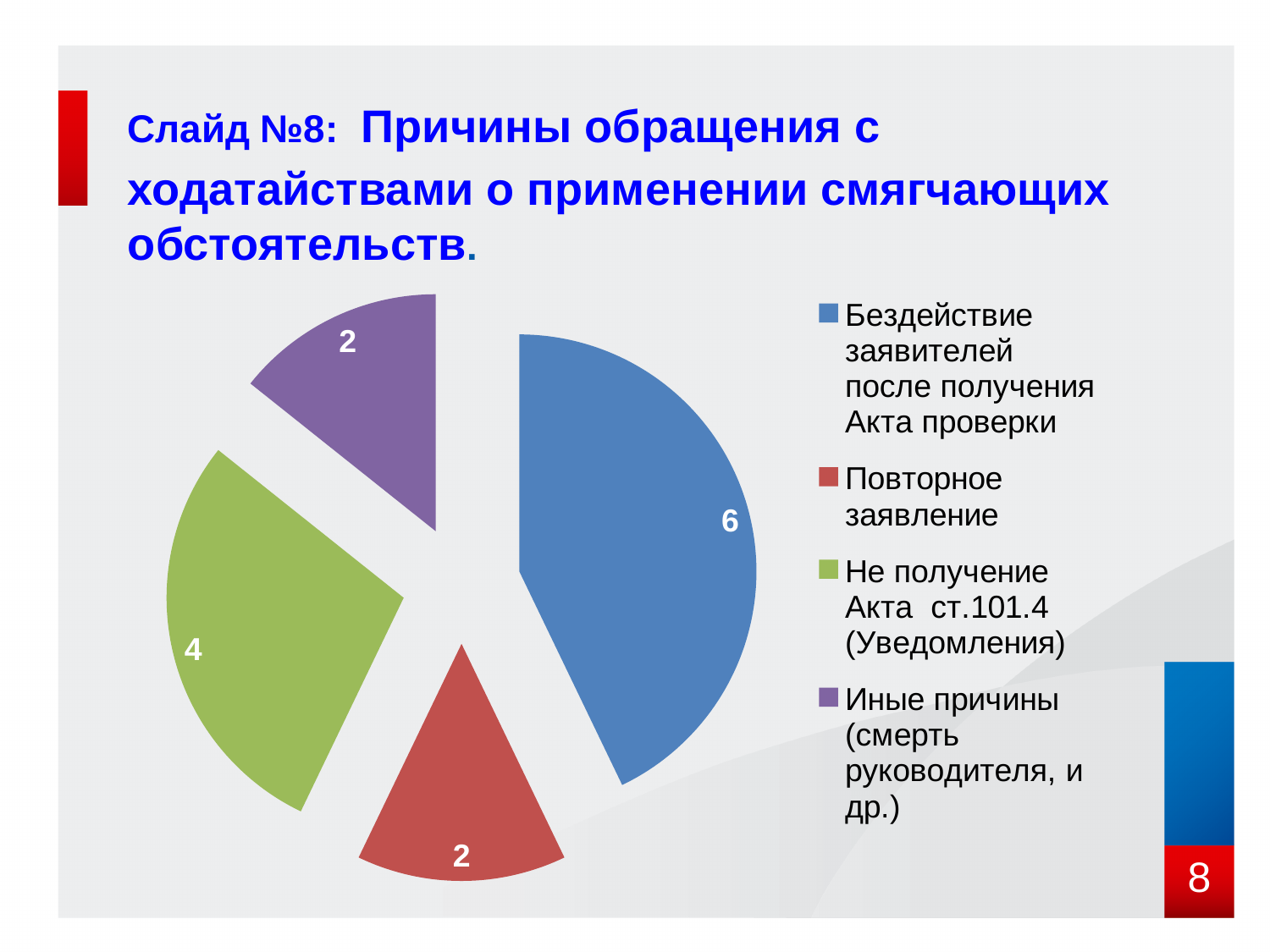
What colour is the slice for 'Иные причины (смерть руководителя, и др.)'? Purple What is the total of all slices in the pie chart? 14 How many slices does the pie chart have? 4 Which category has the largest slice of the pie? Бездействие заявителей после получения Акта проверки What is the value for 'Повторное заявление'? 2 What is the value for 'Не получение Акта ст.101.4 (Уведомления)'? 4 What is the value for 'Бездействие заявителей после получения Акта проверки'? 6 What is the value for 'Иные причины (смерть руководителя, и др.)'? 2 What kind of chart is shown on the slide? Pie chart Which is larger: the value for 'Не получение Акта ст.101.4 (Уведомления)' or for 'Повторное заявление'? Не получение Акта ст.101.4 (Уведомления) What is the difference between the values for 'Бездействие заявителей после получения Акта проверки' and 'Не получение Акта ст.101.4 (Уведомления)'? 2 How many entries does the legend list? 4